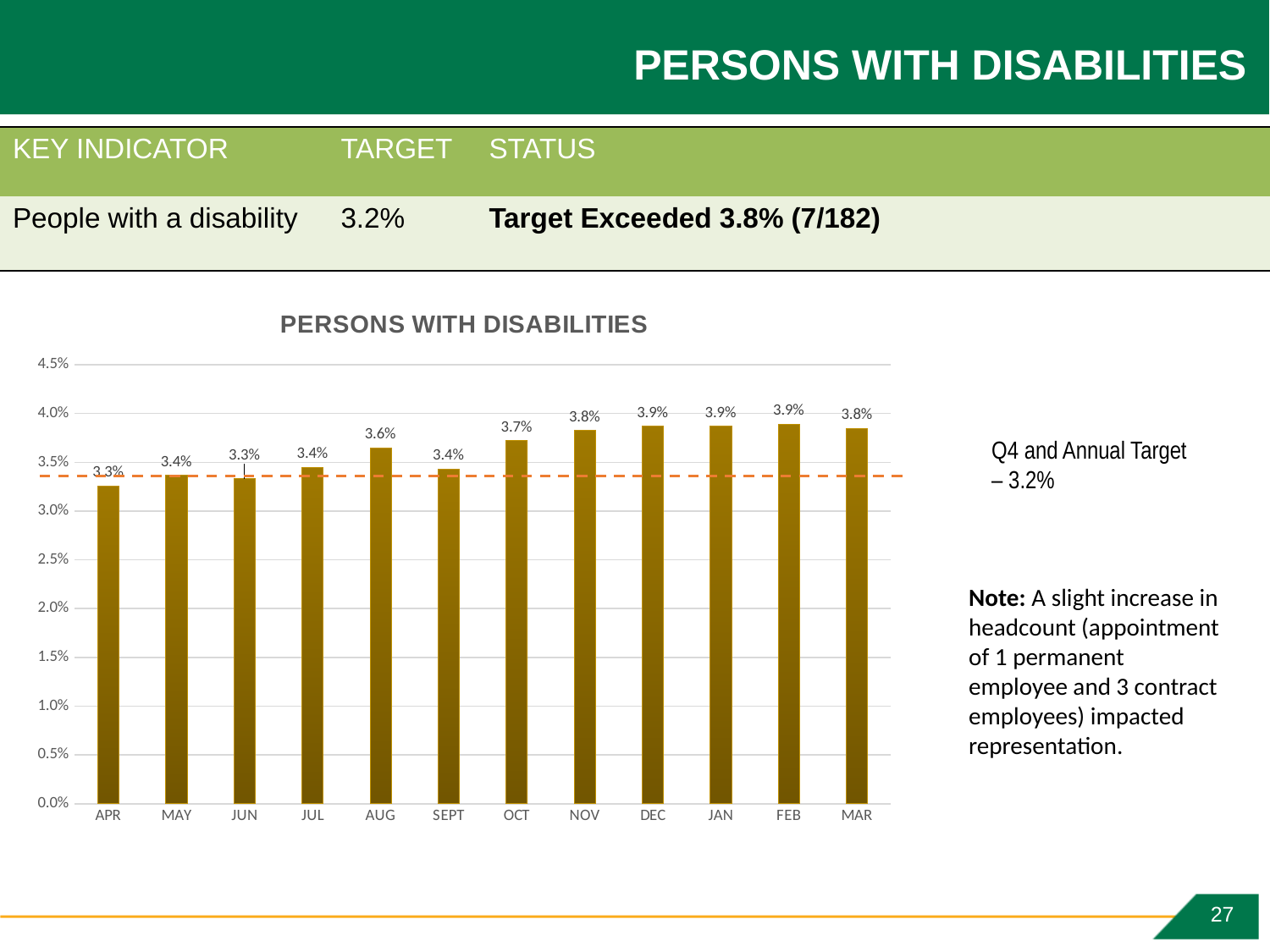
What is the value for AUG? 3.6% How many months are shown on the x axis? 12 Which is larger, the value for AUG or the value for SEPT? AUG What is the title of the chart? PERSONS WITH DISABILITIES What is the lowest value shown on the chart? 3.3% Do the values generally rise or fall from APR to MAR? rise What kind of chart is shown on the slide? bar chart Is the value for NOV greater or less than 3.5%? greater What is the value for MAR? 3.8% What is the highest value shown on the chart? 3.9% What is the difference between the values for MAR and APR? 0.5% What is the value for OCT? 3.7%